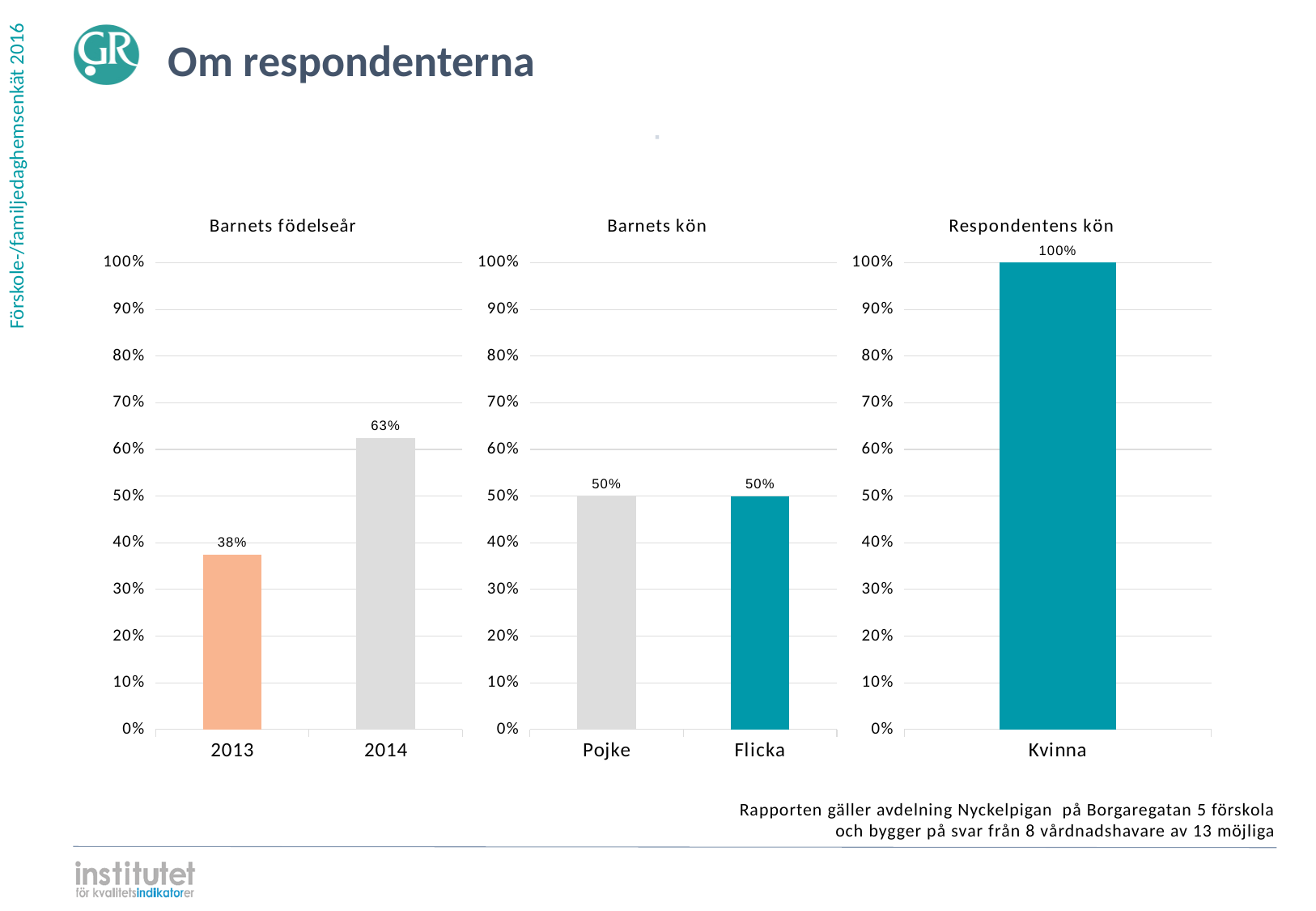
In the 'Barnets kön' chart, what is the value for Pojke? 50% In the 'Barnets födelseår' chart, what is the value for 2013? 38% In the 'Barnets födelseår' chart, what is the value for 2014? 63% What kind of chart is the 'Barnets födelseår' chart? Bar chart In the 'Barnets kön' chart, what is the value for Flicka? 50% In the 'Barnets födelseår' chart, is the value for 2013 greater or less than 40%? less In the 'Barnets kön' chart, how many categories are shown? 2 In the 'Respondentens kön' chart, how many categories are shown? 1 How many charts are shown on the slide? 3 In the 'Barnets födelseår' chart, which category has the highest value? 2014 In the 'Barnets födelseår' chart, what is the difference between the values for 2014 and 2013? 25% In the 'Respondentens kön' chart, what is the value for Kvinna? 100%